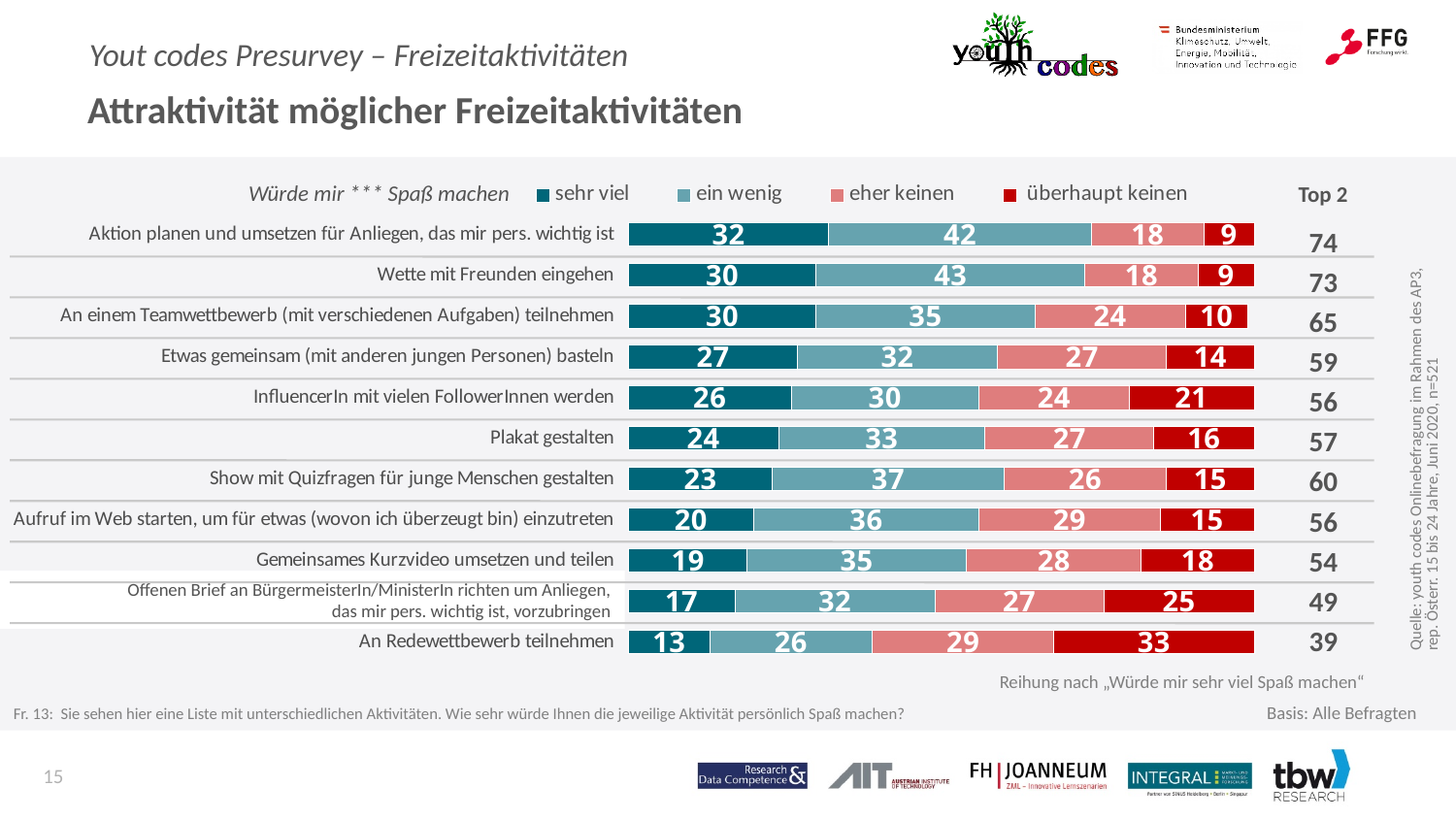
What is the 'sehr viel' value for 'Plakat gestalten'? 24 What is the total of the stacked bar for 'Etwas gemeinsam (mit anderen jungen Personen) basteln'? 100 Which activity has the highest 'sehr viel' value? Aktion planen und umsetzen für Anliegen, das mir pers. wichtig ist Which has the larger 'eher keinen' value: 'Aufruf im Web starten, um für etwas (wovon ich überzeugt bin) einzutreten' or 'InfluencerIn mit vielen FollowerInnen werden'? Aufruf im Web starten, um für etwas (wovon ich überzeugt bin) einzutreten What kind of chart is shown on the slide? stacked bar chart How many series does the chart legend list? 4 What is the Top 2 value shown for 'Gemeinsames Kurzvideo umsetzen und teilen'? 54 How many activities (categories) are plotted in the chart? 11 What is the 'überhaupt keinen' value for 'An Redewettbewerb teilnehmen'? 33 Which activity has the lowest 'sehr viel' value? An Redewettbewerb teilnehmen What is the difference between the 'überhaupt keinen' values for 'An Redewettbewerb teilnehmen' and 'Wette mit Freunden eingehen'? 24 What is the 'ein wenig' value for 'Wette mit Freunden eingehen'? 43